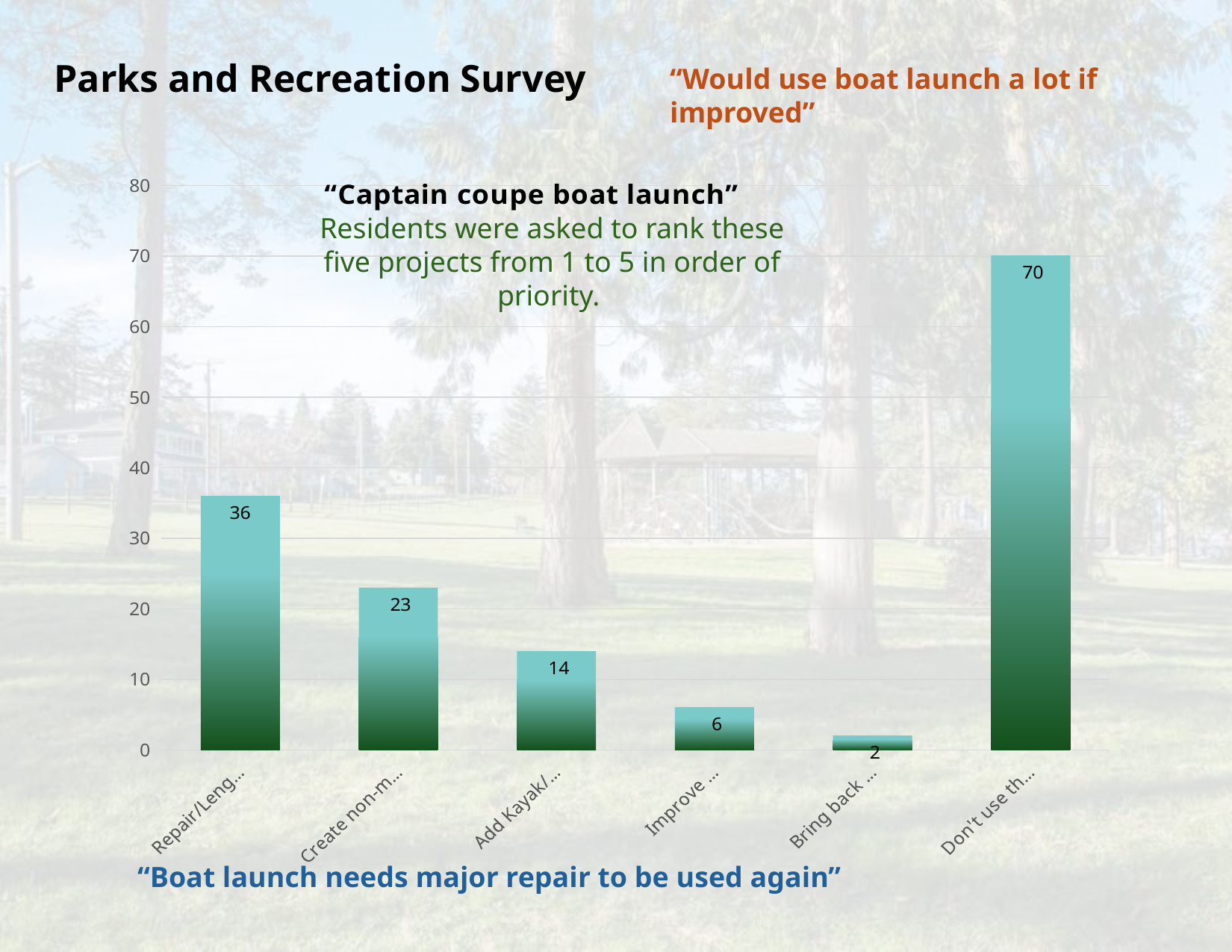
Which bar has the highest value? Don't use th... Which bar has the lowest value? Bring back ... What is the value of the first bar, labelled "Repair/Leng..."? 36 What is the highest value shown on the vertical axis? 80 What is the value of the last bar, labelled "Don't use th..."? 70 What is the value of the bar labelled "Create non-m..."? 23 What is the value of the bar labelled "Add Kayak/..."? 14 What is the difference between the value of the "Don't use th..." bar and the "Repair/Leng..." bar? 34 What is the difference between the values of the "Create non-m..." bar and the "Add Kayak/..." bar? 9 Which is larger, the value for "Improve ..." or the value for "Bring back ..."? Improve ... How many bars (categories) does the chart show? 6 What type of chart is shown on the slide? bar chart